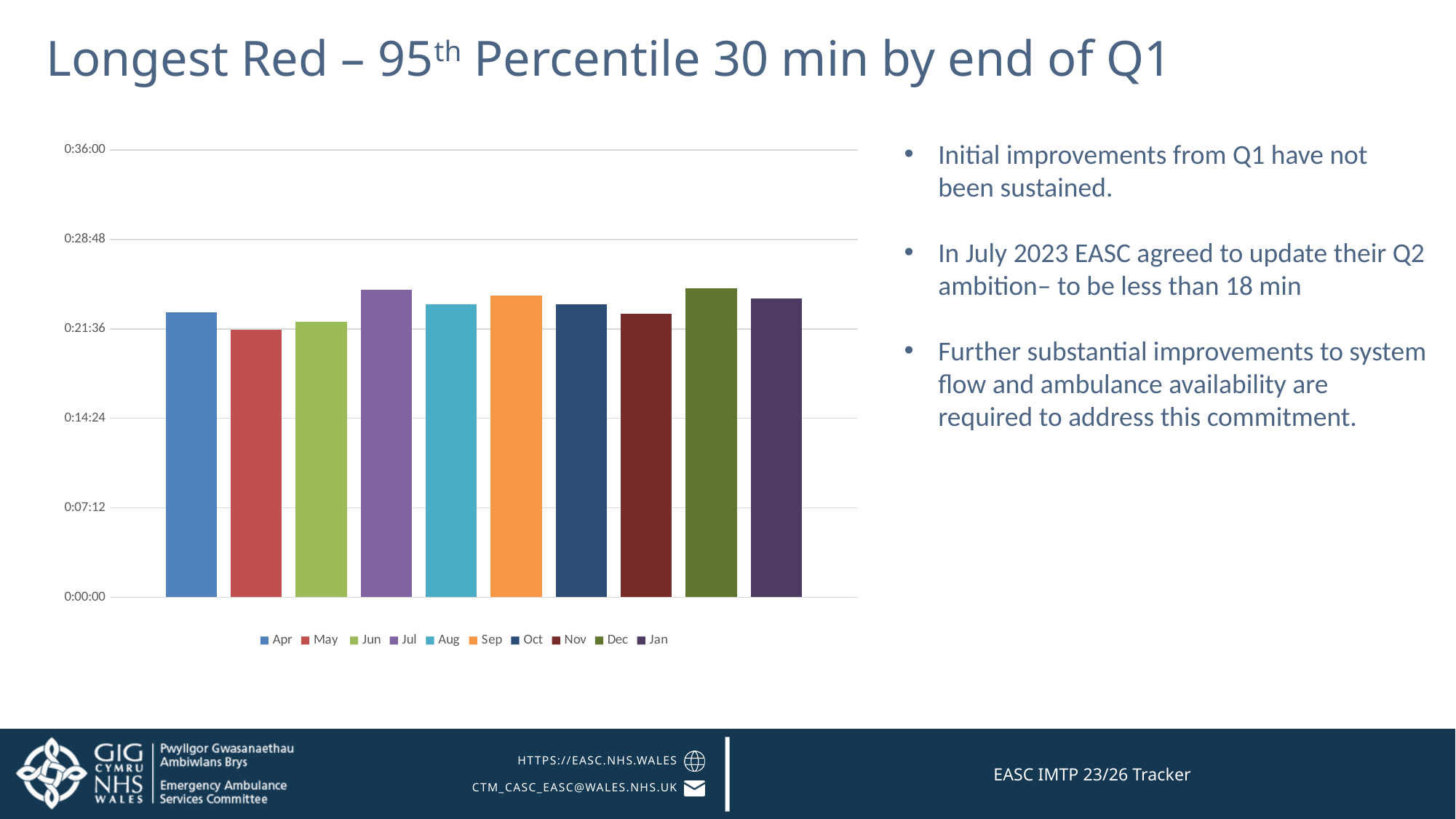
What is the first entry listed in the chart legend? Apr What colour is the bar for Sep? orange Which month has the lowest bar in the chart? May Is the value for Apr greater or less than 0:21:36? greater What kind of chart is shown on the slide? bar chart How many entries does the chart legend list? 10 Is the value for Jul greater or less than 0:28:48? less Which is larger, the value for Sep or the value for Jun? Sep Which is larger, the value for Dec or the value for Nov? Dec How many bars are plotted in the chart? 10 Which is larger, the value for Jul or the value for May? Jul Is the value for Dec greater or less than 0:21:36? greater